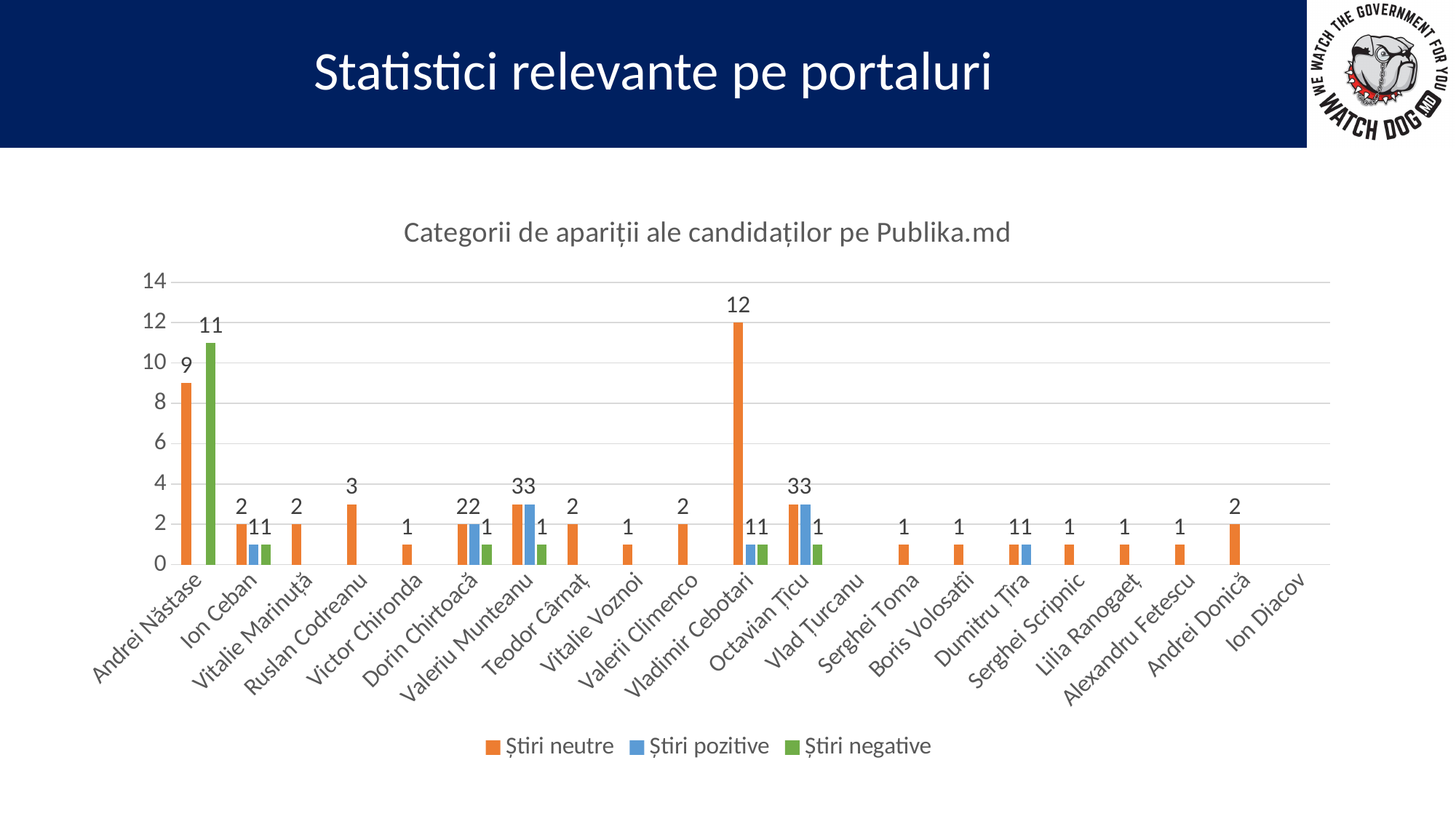
How many series does the legend list? 3 What is the value of Știri pozitive for Valeriu Munteanu? 3 Which colour represents Știri pozitive in the legend? blue What is the value of Știri neutre for Vladimir Cebotari? 12 Which candidate has the highest value for Știri neutre? Vladimir Cebotari Which is larger for Andrei Năstase: Știri neutre or Știri negative? Știri negative Which candidate has the highest value for Știri negative? Andrei Năstase What is the title of the chart? Categorii de apariții ale candidaților pe Publika.md What is the difference between Știri negative and Știri neutre for Andrei Năstase? 2 What is the value of Știri neutre for Ruslan Codreanu? 3 What is the value of Știri negative for Andrei Năstase? 11 What type of chart is shown on the slide? bar chart